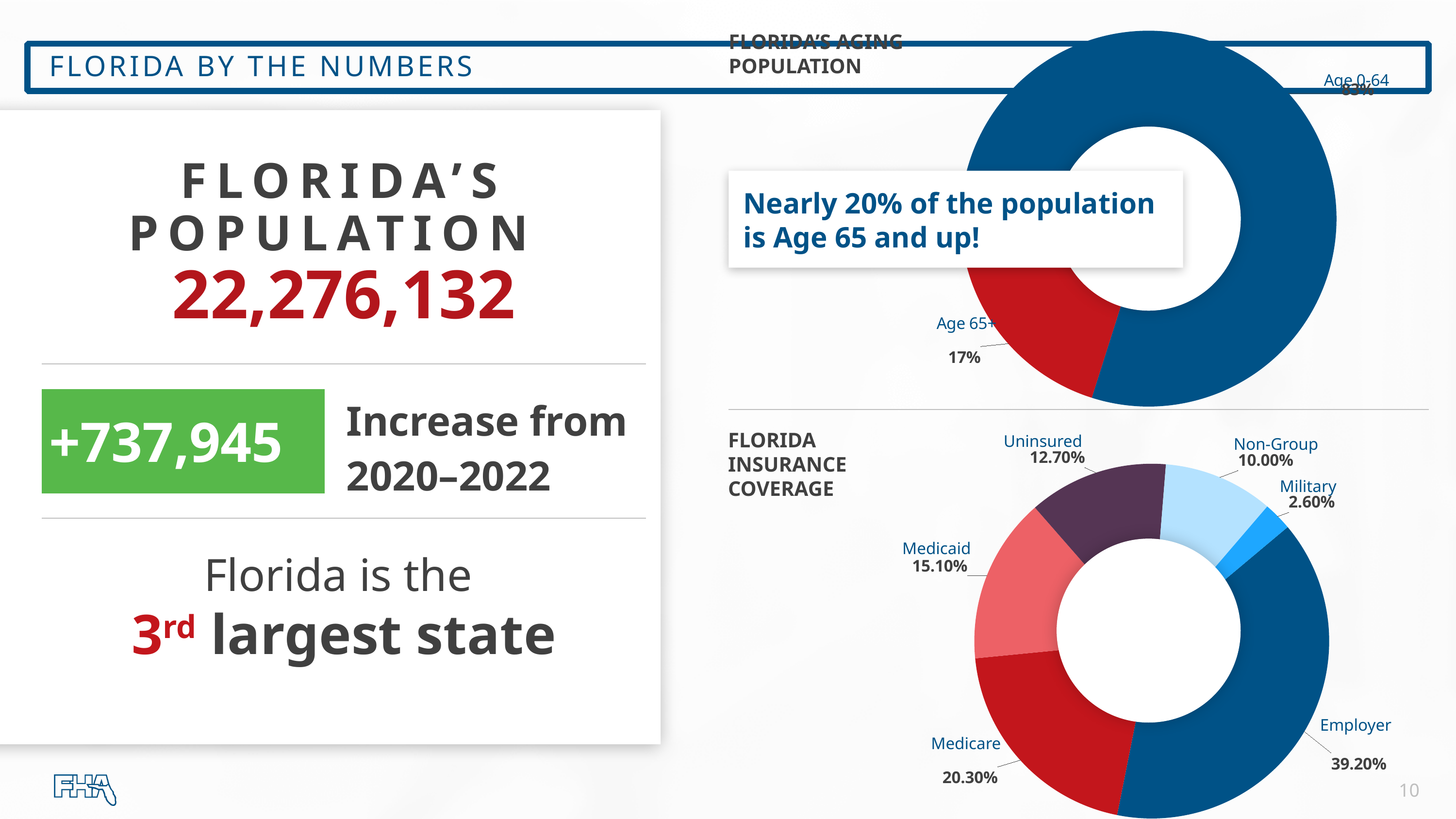
In the Florida Insurance Coverage chart, which coverage category has the largest share? Employer In the Florida Insurance Coverage chart, what percentage is shown for Employer coverage? 39.20% In the Florida Insurance Coverage chart, which coverage category has the smallest share? Military In the Florida's Aging Population chart, what colour is the Age 65+ segment? Red In the Florida's Aging Population chart, which segment is larger, Age 0-64 or Age 65+? Age 0-64 In the Florida Insurance Coverage chart, which is larger, Medicaid or Uninsured? Medicaid How many coverage categories are shown in the Florida Insurance Coverage chart? 6 In the Florida's Aging Population chart, what percentage is shown for Age 65+? 17% In the Florida Insurance Coverage chart, what is the difference between the Employer and Medicare percentages? 18.90% In the Florida Insurance Coverage chart, what percentage is shown for Medicare? 20.30% In the Florida Insurance Coverage chart, what percentage is shown for Military coverage? 2.60% What kind of chart is the Florida Insurance Coverage chart? Donut (pie) chart